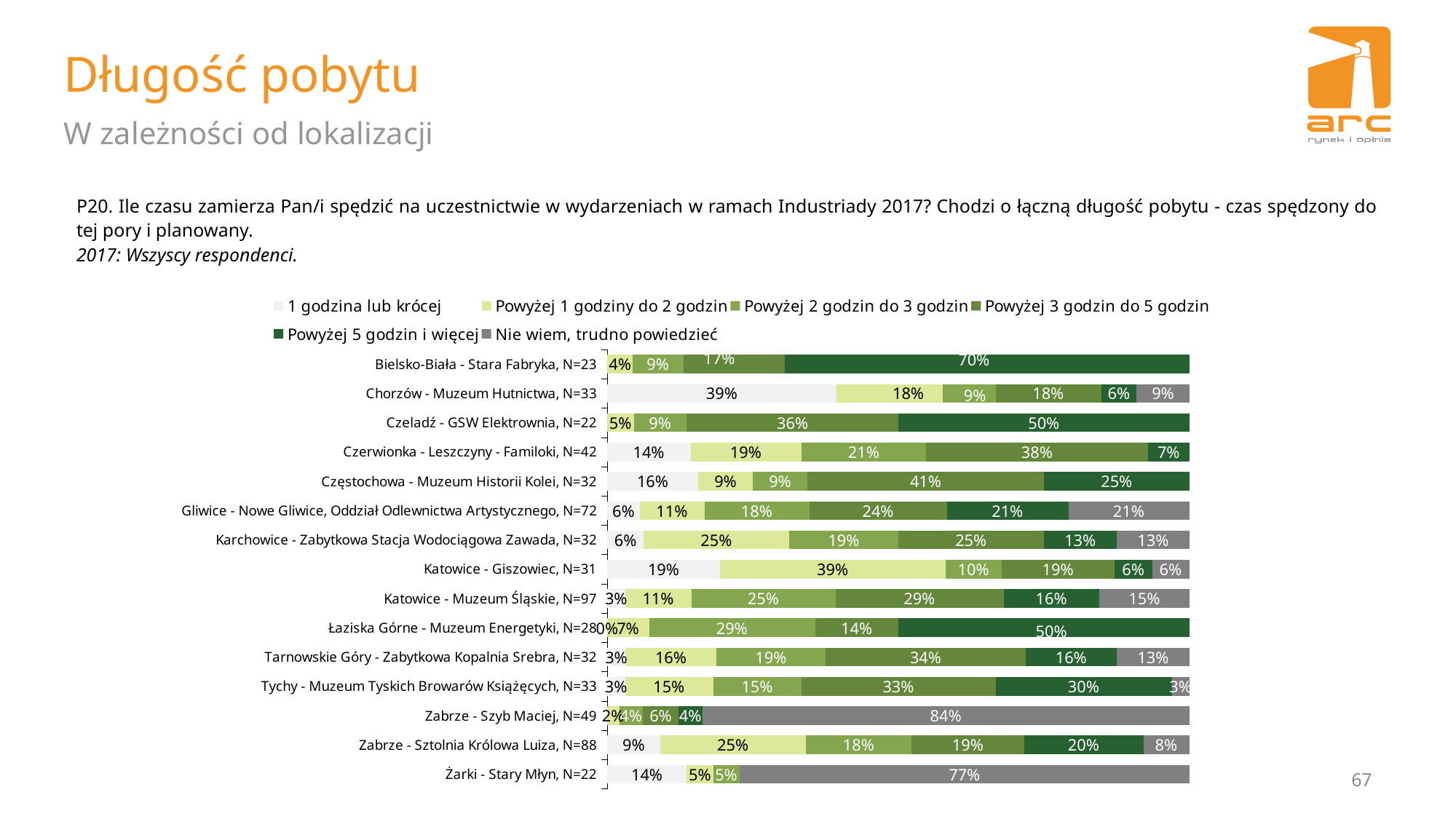
How many series does the chart legend list? 6 How many locations (categories) are plotted in the chart? 15 What is the first entry in the chart legend? 1 godzina lub krócej What is the difference in percentage points between the 'Nie wiem, trudno powiedzieć' share for Zabrze - Szyb Maciej and for Żarki - Stary Młyn? 7 percentage points What kind of chart is shown on the slide? Stacked bar chart What is the value of 'Nie wiem, trudno powiedzieć' for Żarki - Stary Młyn, N=22? 77% Which has a larger share of '1 godzina lub krócej': Chorzów - Muzeum Hutnictwa or Katowice - Giszowiec? Chorzów - Muzeum Hutnictwa What is the value of 'Powyżej 5 godzin i więcej' for Bielsko-Biała - Stara Fabryka, N=23? 70% Which location has the highest share of 'Nie wiem, trudno powiedzieć'? Zabrze - Szyb Maciej, N=49 What is the value of 'Powyżej 1 godziny do 2 godzin' for Katowice - Giszowiec, N=31? 39% What is the value of '1 godzina lub krócej' for Chorzów - Muzeum Hutnictwa, N=33? 39% What is the value of 'Nie wiem, trudno powiedzieć' for Zabrze - Szyb Maciej, N=49? 84%